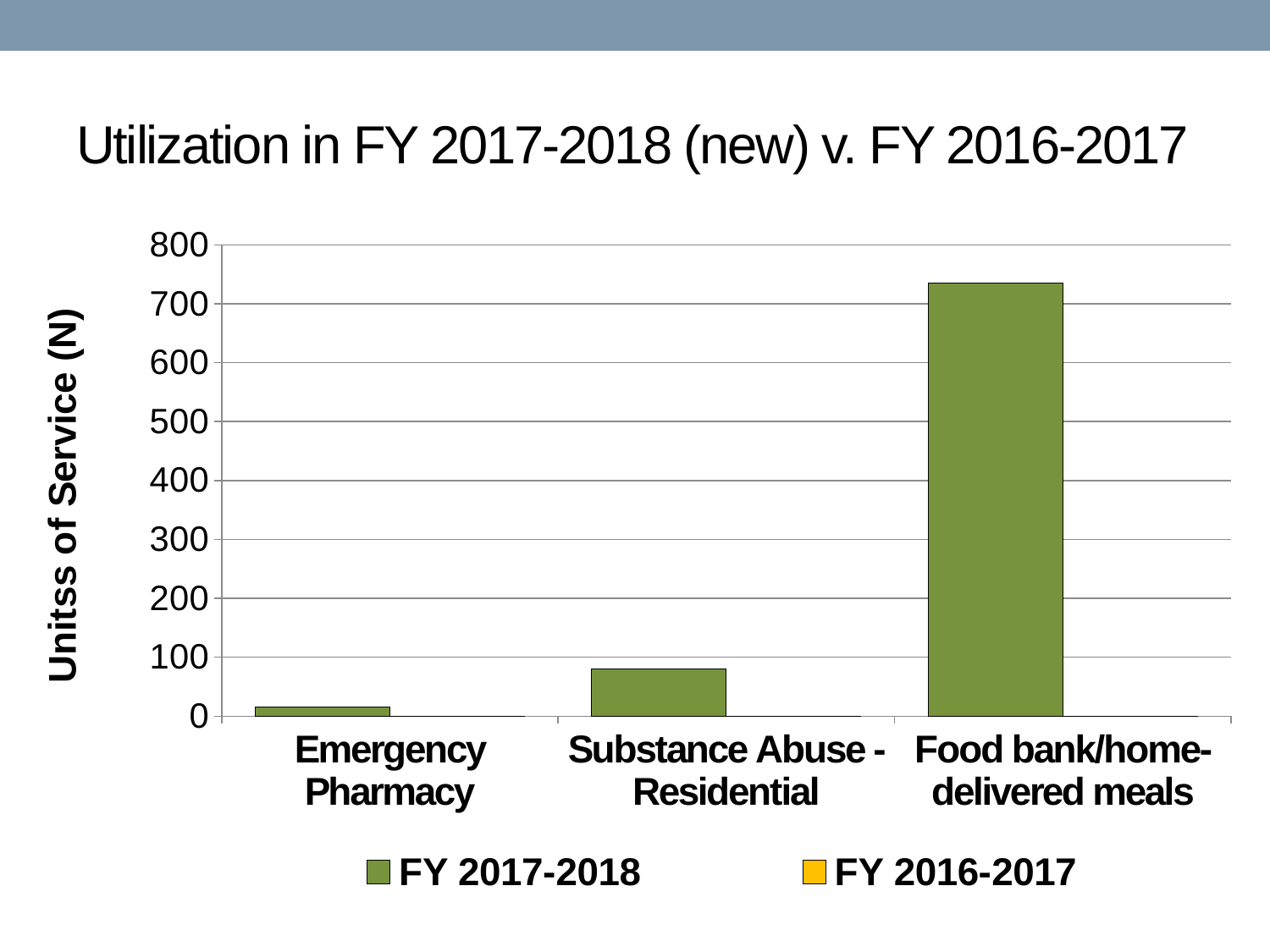
Which has a larger FY 2017-2018 value, Substance Abuse - Residential or Emergency Pharmacy? Substance Abuse - Residential Is the FY 2017-2018 value for Emergency Pharmacy greater or less than 100? less Is the FY 2017-2018 value for Food bank/home-delivered meals greater or less than 700? greater How many categories are shown on the x axis of the chart? 3 What is the title of the chart? Utilization in FY 2017-2018 (new) v. FY 2016-2017 Is the FY 2017-2018 value for Substance Abuse - Residential greater or less than 100? less Which category has the highest FY 2017-2018 value? Food bank/home-delivered meals Do the FY 2017-2018 values rise or fall moving from left to right along the x axis? Rise Which category has the lowest FY 2017-2018 value? Emergency Pharmacy How many series does the chart's legend list? 2 What is the label on the y axis of the chart? Unitss of Service (N) What kind of chart is shown on the slide? Bar chart